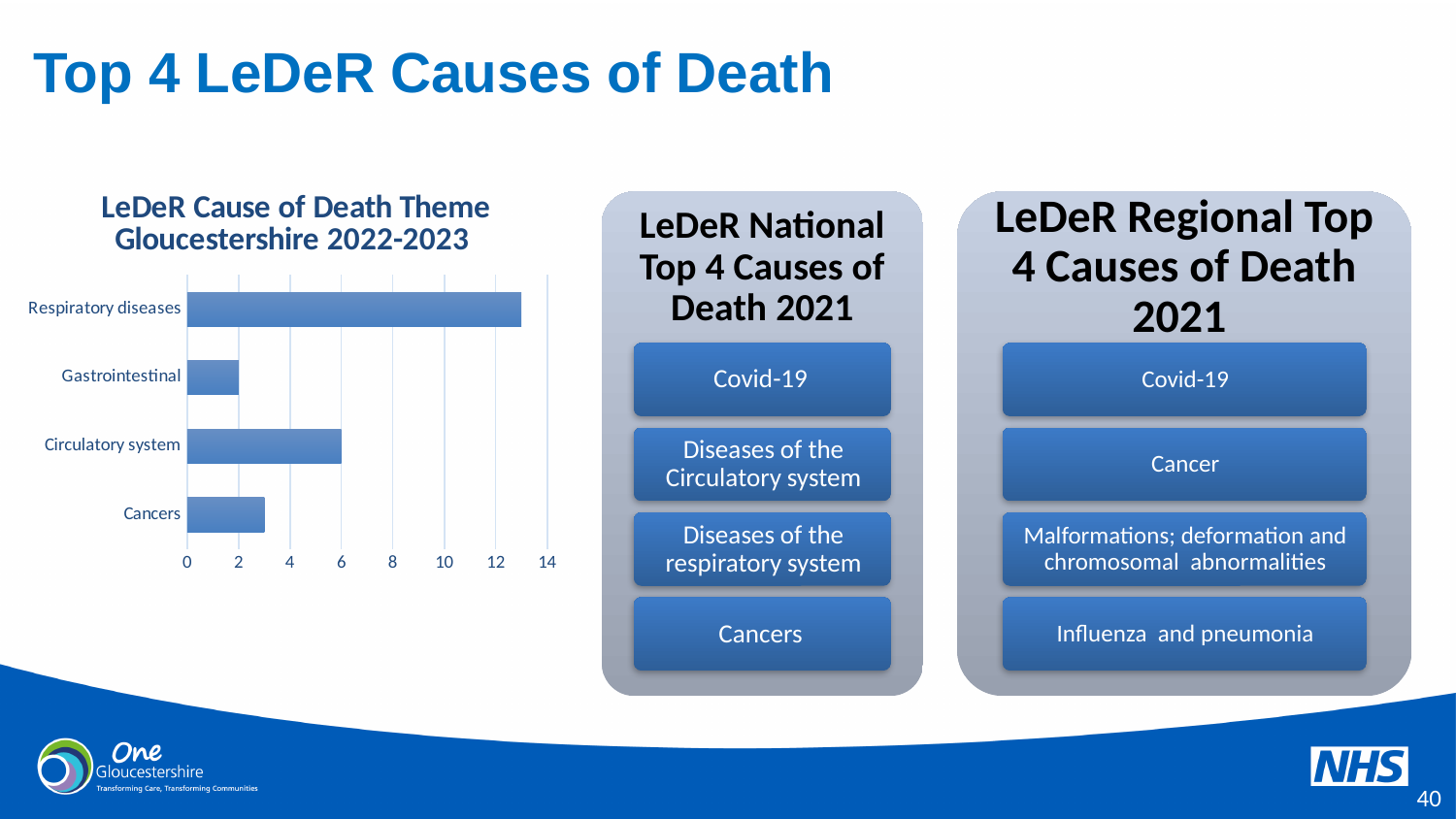
Which category has the lowest value in the bar chart? Gastrointestinal Is the value for Respiratory diseases greater or less than 12? greater Is the value for Cancers greater or less than 4? less What is the difference between the values for Circulatory system and Gastrointestinal? 4 Which category has the highest value in the bar chart? Respiratory diseases What is the title of the bar chart? LeDeR Cause of Death Theme Gloucestershire 2022-2023 How many categories does the bar chart show? 4 What type of chart is shown on the slide? Bar chart Which is larger in the bar chart, Circulatory system or Cancers? Circulatory system What is the value for Gastrointestinal in the bar chart? 2 What is the highest value shown on the x axis of the bar chart? 14 What is the value for Circulatory system in the bar chart? 6